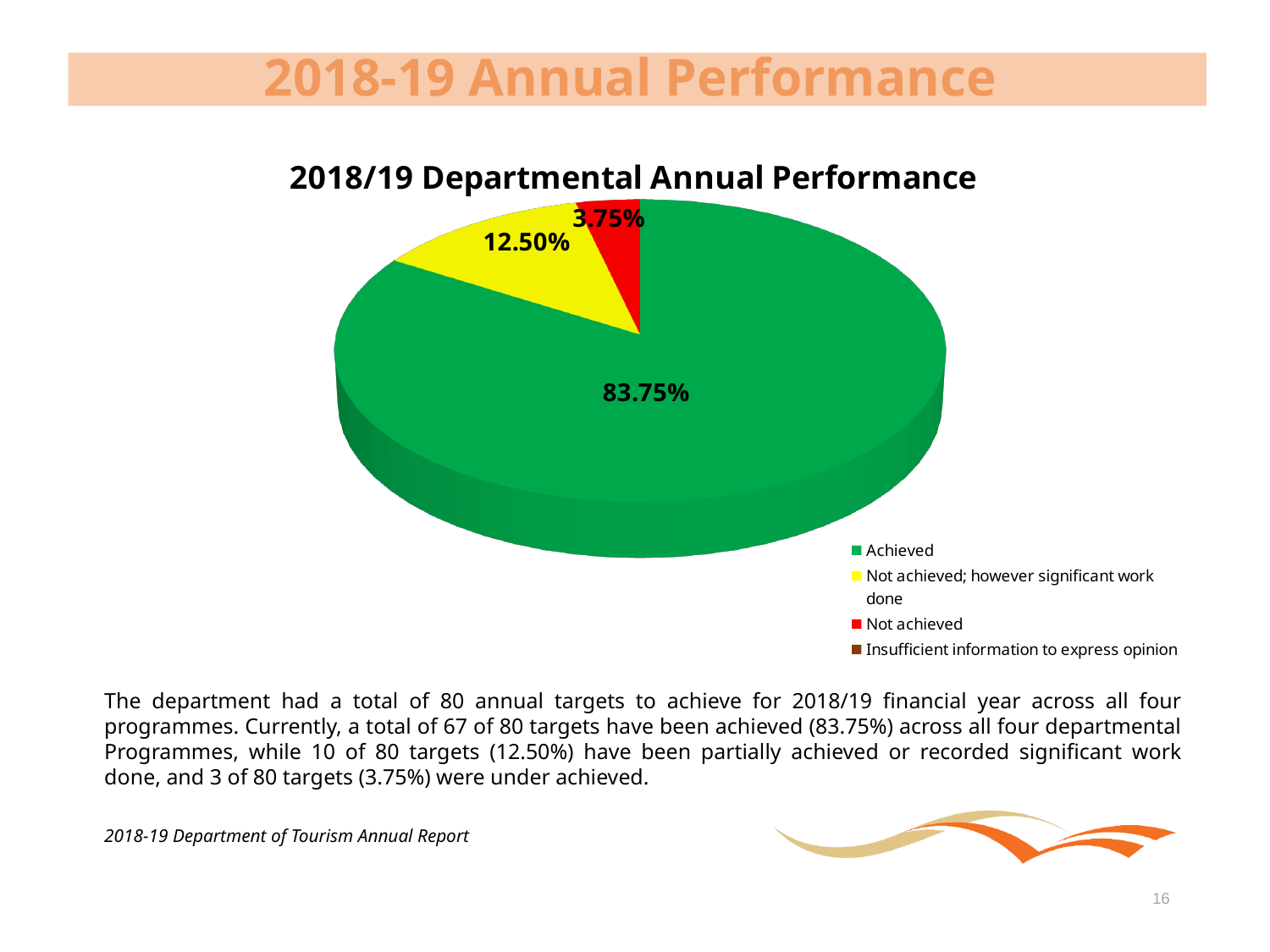
What is the title of the chart? 2018/19 Departmental Annual Performance What type of chart is shown on the slide? Pie chart Which category has the largest share of the pie? Achieved Which is larger: the 'Not achieved; however significant work done' slice or the 'Not achieved' slice? Not achieved; however significant work done What percentage of targets is shown as Achieved? 83.75% How many slices are visibly labelled with a percentage on the pie chart? 3 What percentage is shown for the 'Not achieved; however significant work done' category? 12.50% What percentage is shown for the 'Not achieved' category? 3.75% How many entries does the legend list? 4 Which category with a visible slice has the smallest share of the pie? Not achieved What colour represents the Achieved category in the pie chart? Green What is the difference in percentage points between the Achieved slice and the 'Not achieved; however significant work done' slice? 71.25%